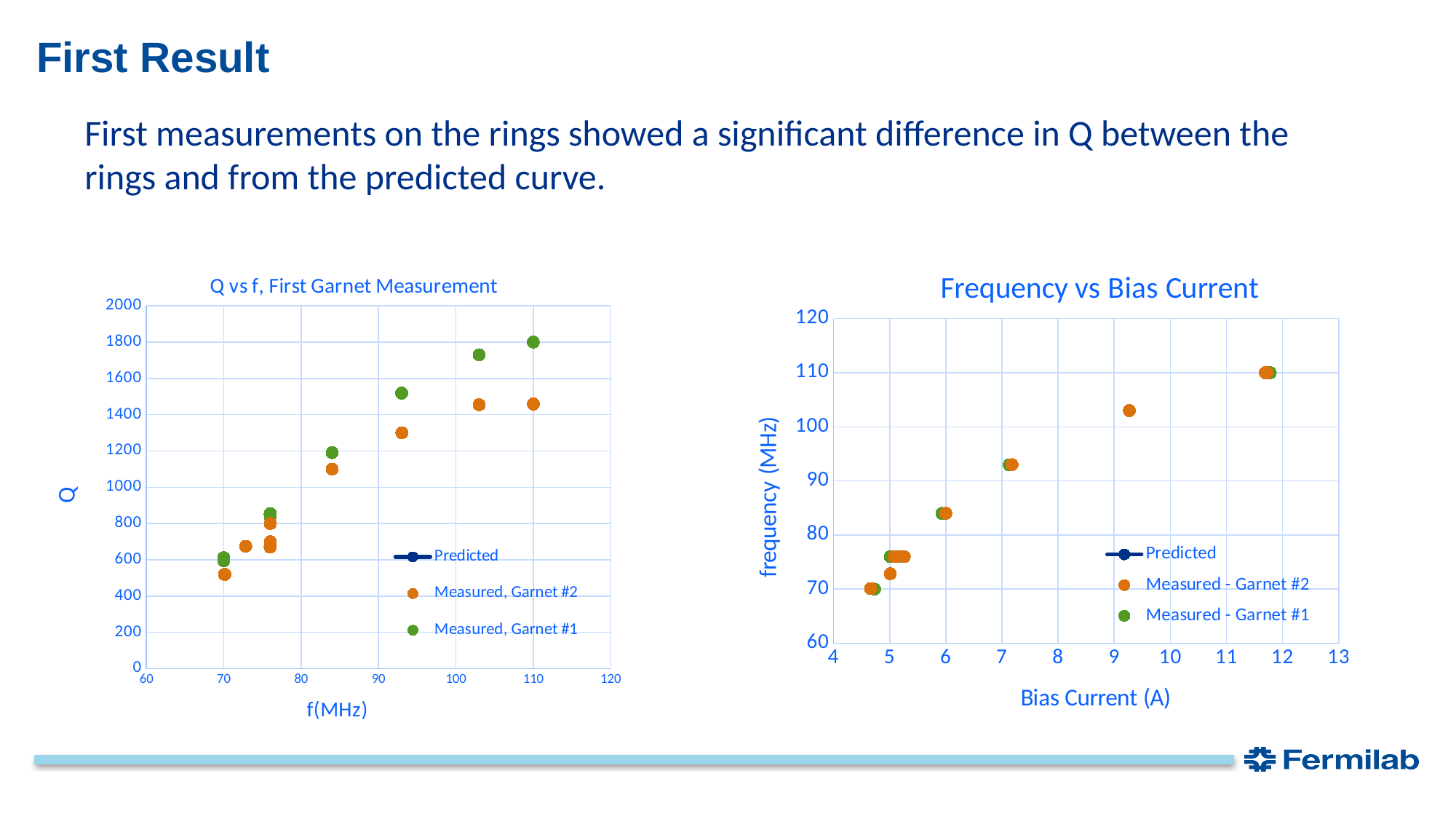
In the 'Frequency vs Bias Current' chart, is the measured frequency at the highest bias current (near 12 A) greater or less than 100 MHz? greater What is the x-axis title of the 'Q vs f, First Garnet Measurement' chart? f(MHz) What is the y-axis title of the 'Frequency vs Bias Current' chart? frequency (MHz) How many series does the legend of the 'Q vs f, First Garnet Measurement' chart list? 3 In the 'Q vs f, First Garnet Measurement' chart, which series has the higher Q at 110 MHz, Measured, Garnet #1 or Measured, Garnet #2? Measured, Garnet #1 What kind of chart is the 'Q vs f, First Garnet Measurement' chart? scatter chart In the 'Q vs f, First Garnet Measurement' chart, do the measured Q values rise or fall as frequency increases? rise In the 'Frequency vs Bias Current' chart, does frequency rise or fall as bias current increases? rise In the 'Q vs f, First Garnet Measurement' chart, is the Q value for Measured, Garnet #2 at 110 MHz greater or less than 1600? less In the 'Q vs f, First Garnet Measurement' chart, is the Q value for Measured, Garnet #1 at 110 MHz greater or less than 1600? greater How many series does the legend of the 'Frequency vs Bias Current' chart list? 3